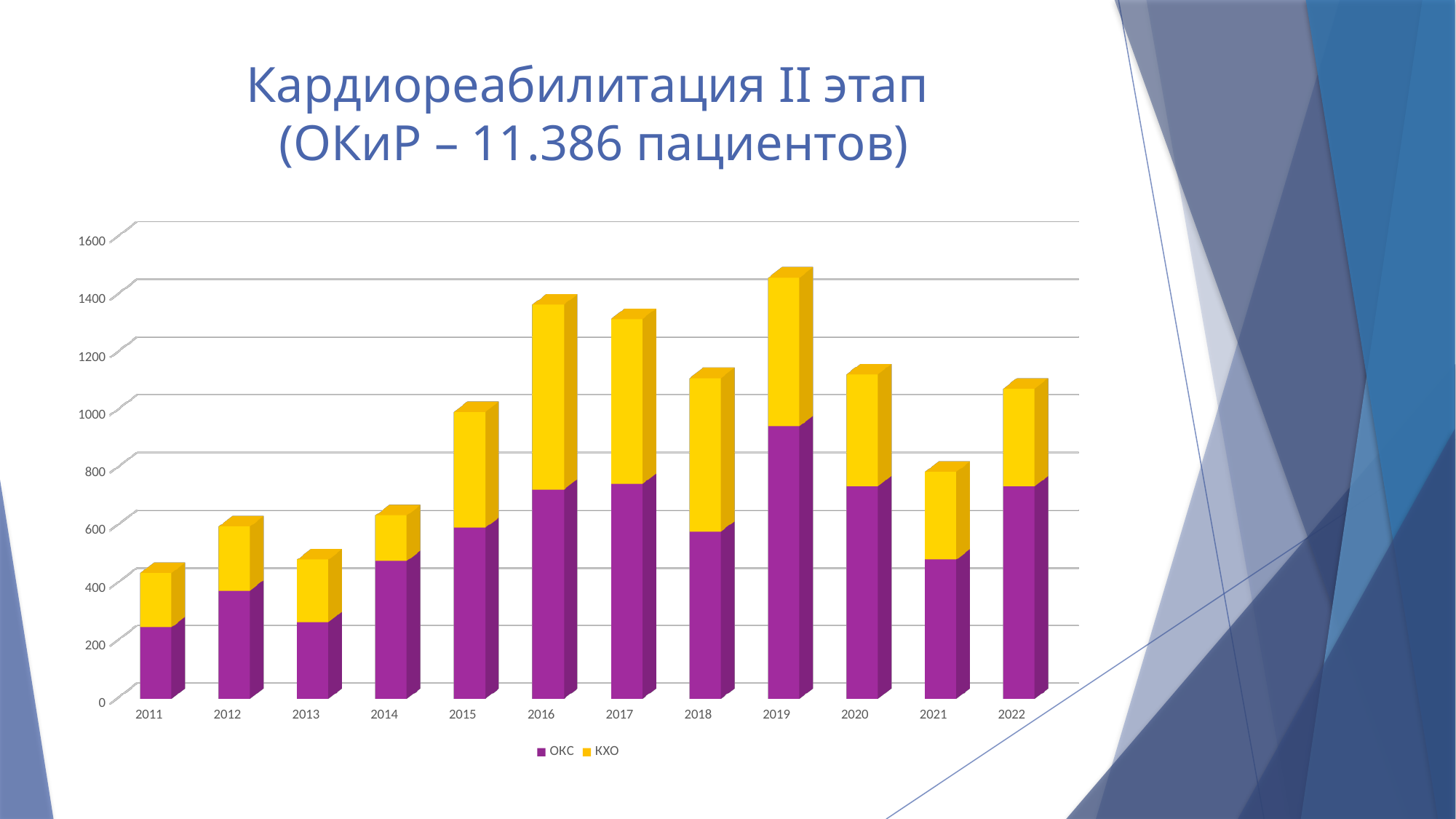
Is the ОКС value for 2019 greater or less than 800? greater Which year has the highest total stacked bar? 2019 Is the total value for 2013 greater or less than 600? less Which year has the highest ОКС value? 2019 Which year has the larger total bar, 2015 or 2014? 2015 What kind of chart is shown on the slide? bar chart Which series are listed in the chart legend? ОКС and КХО Which year has the lowest total stacked bar? 2011 How many series does the chart legend list? 2 How many years are shown on the x axis of the chart? 12 Is the total value for 2016 greater or less than 1200? greater Do the total bar heights rise or fall from 2019 to 2021? fall